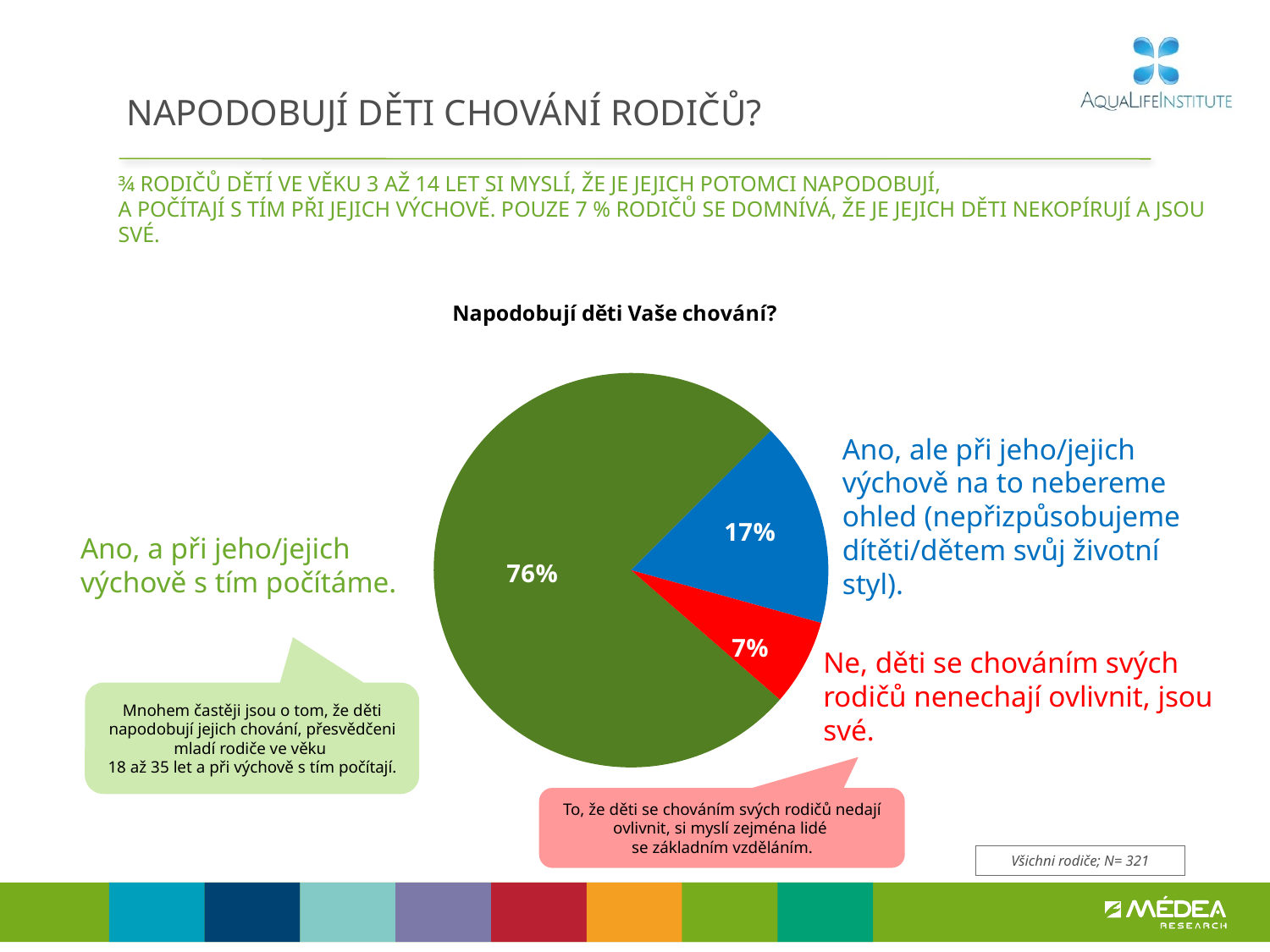
What is the difference in percentage points between the blue slice (17%) and the red slice (7%)? 10 What share of the pie is the green slice labelled "Ano, a při jeho/jejich výchově s tím počítáme."? 76% Which answer has the largest share of the pie? Ano, a při jeho/jejich výchově s tím počítáme. How many slices does the pie chart have? 3 What kind of chart is shown on the slide? pie chart What is the difference in percentage points between the green slice (76%) and the blue slice (17%)? 59 What colour is the slice representing 7%? red Which slice is larger, the blue one or the red one? the blue one What is the title of the chart? Napodobují děti Vaše chování? What share of the pie is the blue slice ("Ano, ale při jeho/jejich výchově na to nebereme ohled")? 17% Which answer has the smallest share of the pie? Ne, děti se chováním svých rodičů nenechají ovlivnit, jsou své. What share of the pie is the red slice ("Ne, děti se chováním svých rodičů nenechají ovlivnit, jsou své.")? 7%